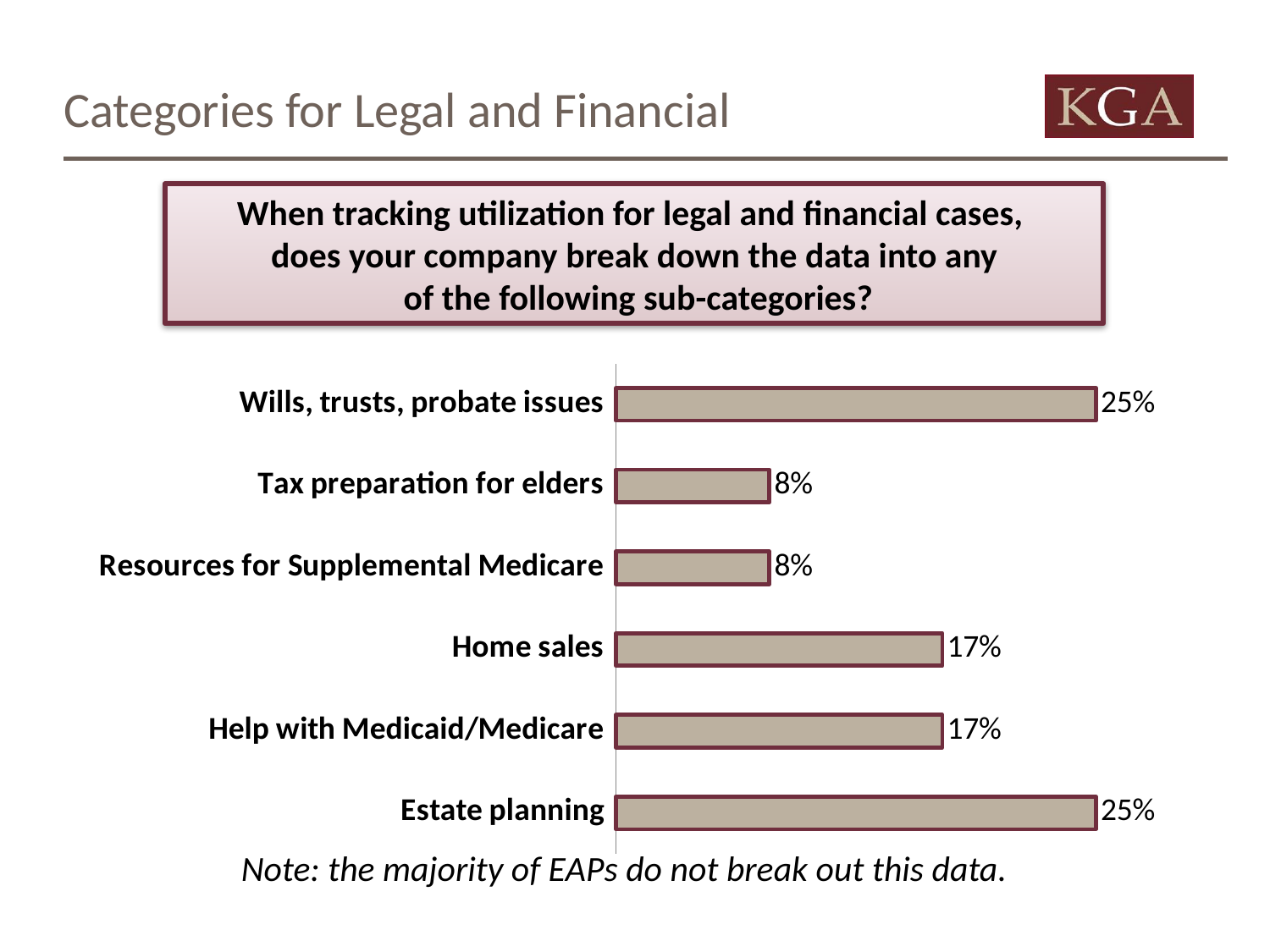
What is the difference between the values for Estate planning and Home sales? 8% What is the value for Wills, trusts, probate issues? 25% Which is larger, the value for Home sales or the value for Resources for Supplemental Medicare? Home sales How many categories are shown in the chart? 6 Which categories have the lowest value? Tax preparation for elders and Resources for Supplemental Medicare What is the value for Help with Medicaid/Medicare? 17% What does the note below the chart say? Note: the majority of EAPs do not break out this data. What is the value for Estate planning? 25% What is the difference between the values for Wills, trusts, probate issues and Tax preparation for elders? 17% What is the value for Home sales? 17% What kind of chart is shown on the slide? Bar chart What is the value for Tax preparation for elders? 8%